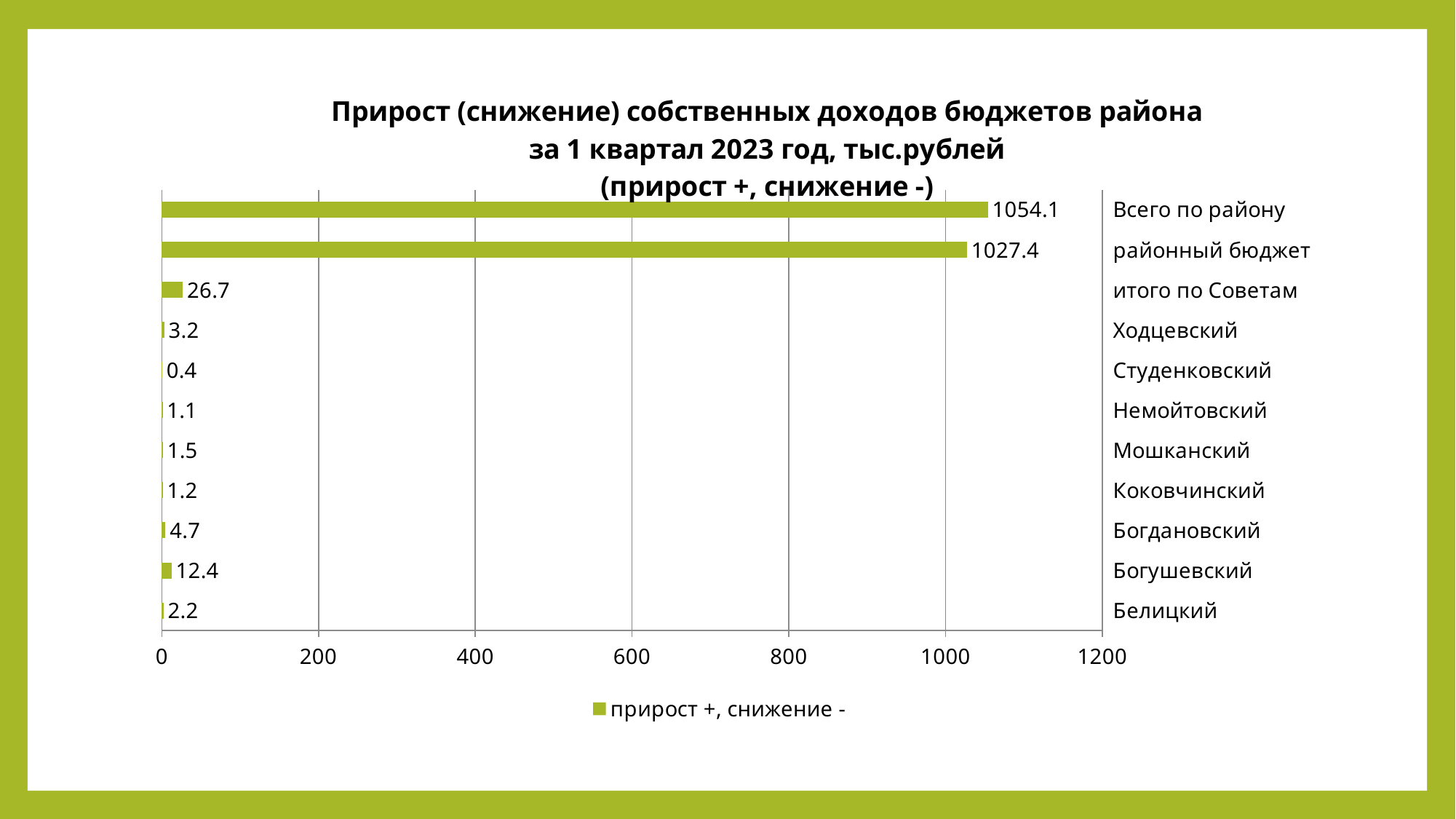
What is the value for районный бюджет? 1027.4 Which category has the highest value? Всего по району What is the value for Студенковский? 0.4 What is the value for Всего по району? 1054.1 How many categories are shown in the chart? 11 What is the legend entry of the chart? прирост +, снижение - What is the value for Богушевский? 12.4 What kind of chart is this? bar chart Is the value for районный бюджет greater or less than 1000? greater Which category has the lowest value? Студенковский Which is larger, the value for Богушевский or the value for Богдановский? Богушевский What is the difference between Всего по району and районный бюджет? 26.7